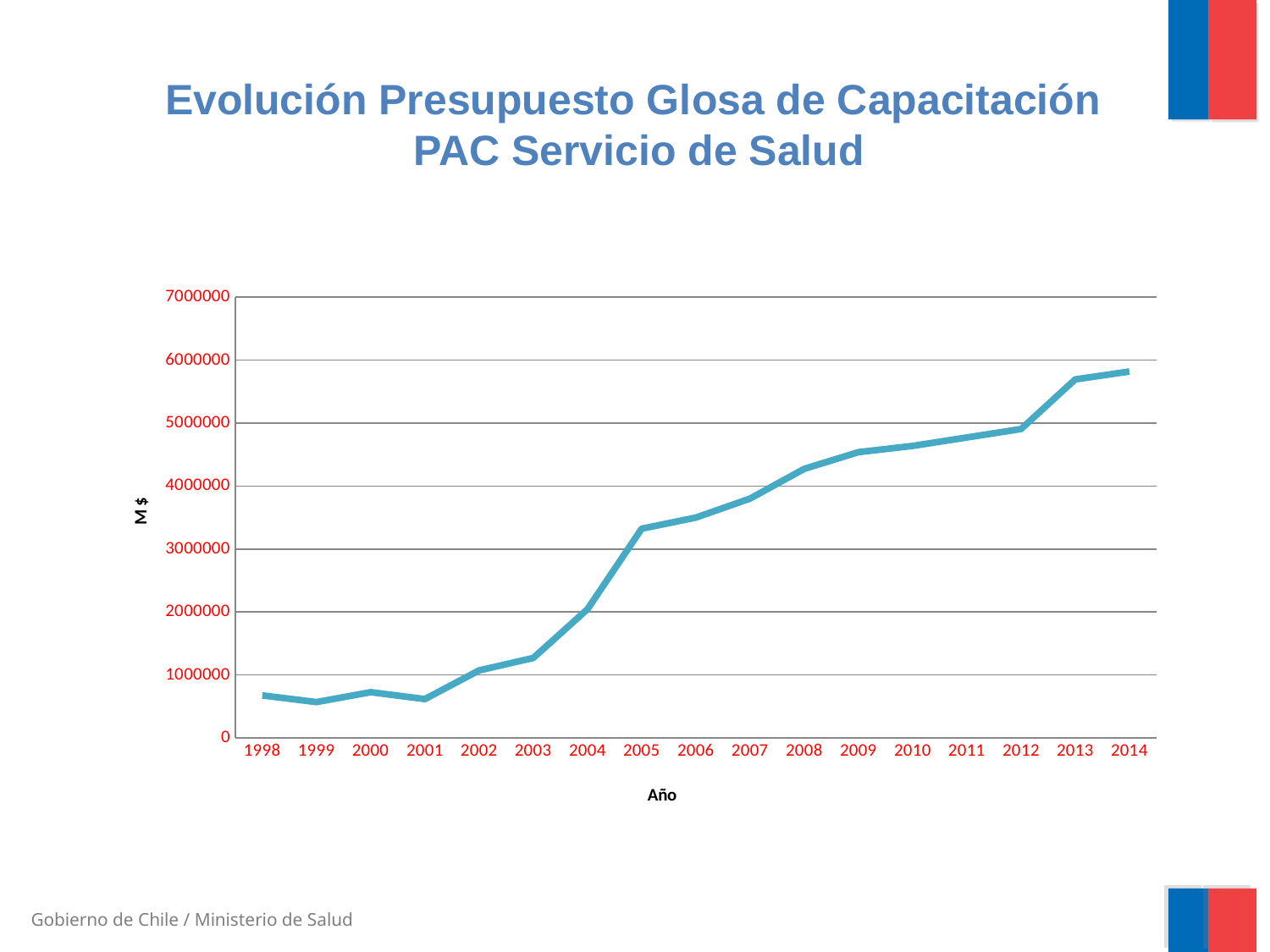
What is the label on the y axis? M $ Is the value for 2005 greater or less than 3000000? greater Which year has the highest value? 2014 Is the value for 2012 greater or less than 5000000? less Which is larger, the value for 2004 or the value for 2005? 2005 Is the value for 2008 greater or less than 4000000? greater What is the label on the x axis? Año Do the values generally rise or fall from 1998 to 2014? rise How many years are plotted along the x axis? 17 What kind of chart is shown on the slide? line chart